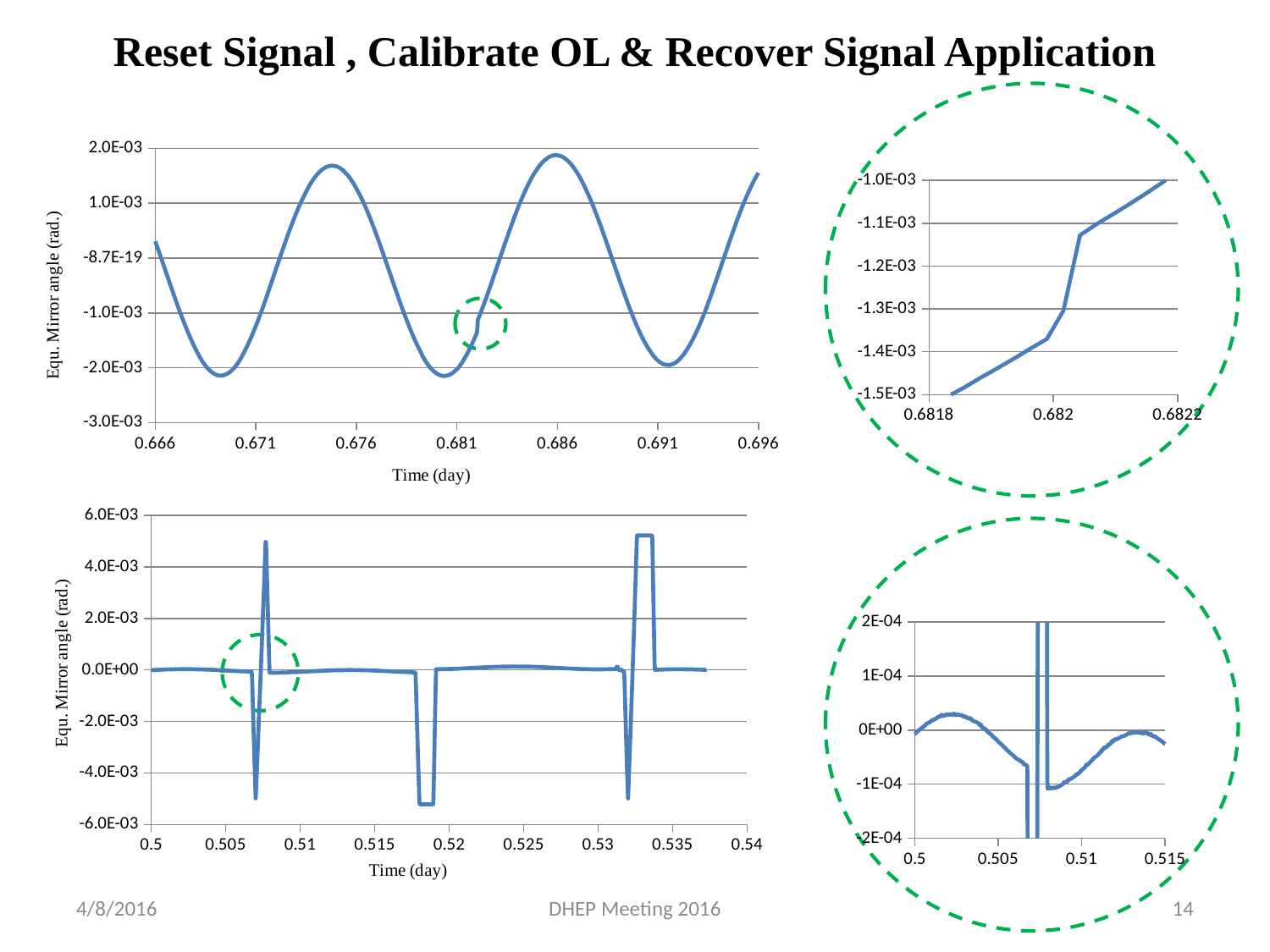
In the bottom-right zoomed chart (x axis 0.5 to 0.515), is the value at time 0.5025 greater or less than 0E+00? greater In the bottom-left chart, is the plateau value near time 0.533 greater or less than 4.0E-03? greater In the top-left chart, is the value at time 0.691 greater or less than -1.0E-03? less In the top-right zoomed chart (x axis 0.6818 to 0.6822), do the values rise or fall along the x axis? rise How many charts are shown on the slide? 4 What is the y-axis title of the top-left chart? Equ. Mirror angle (rad.) What kind of chart is the top-left chart on the slide? line chart